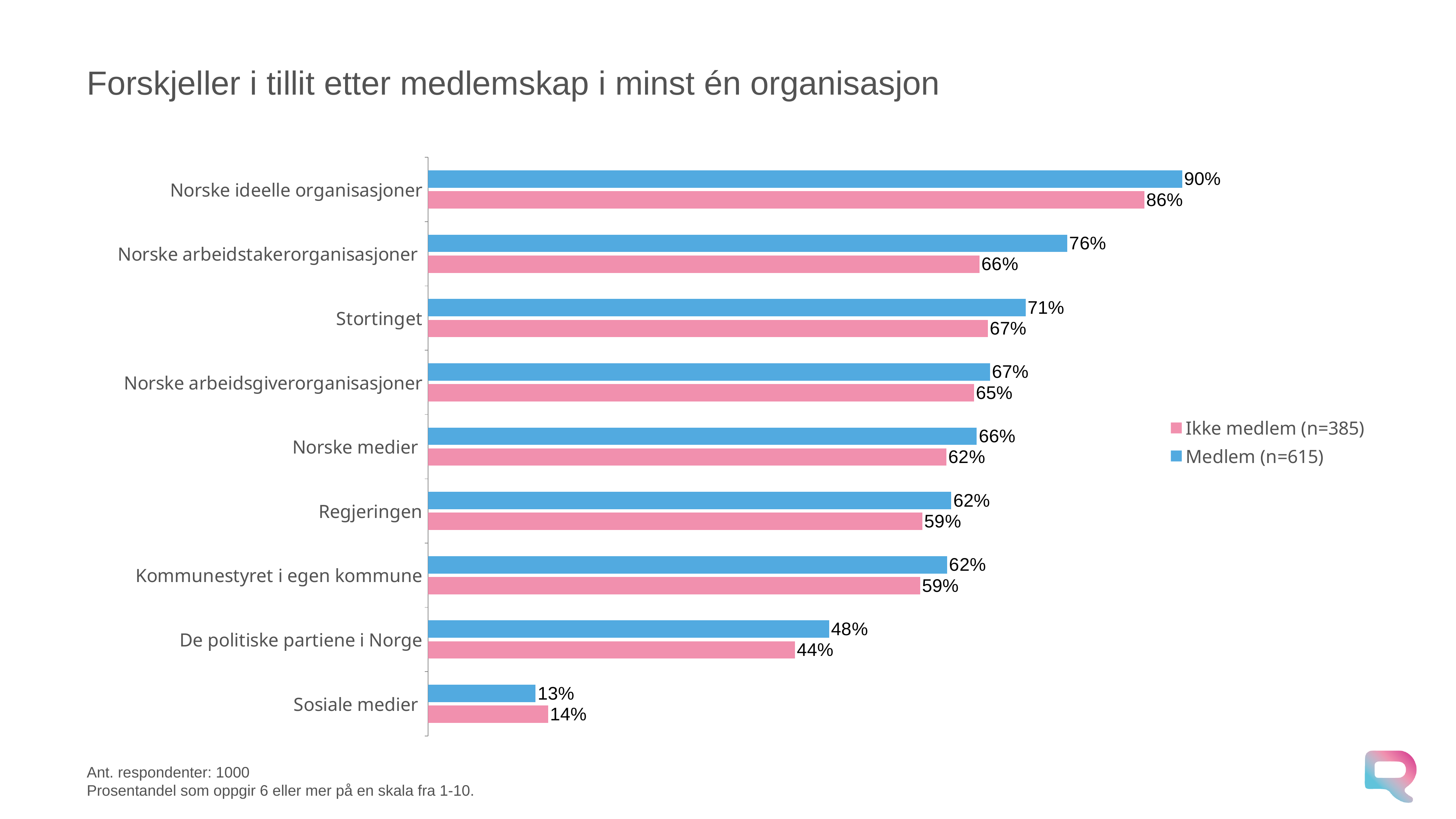
What is the value for Ikke medlem (n=385) for Sosiale medier? 14% What is the value for Ikke medlem (n=385) for Norske arbeidstakerorganisasjoner? 66% For Sosiale medier, which series has the larger value: Medlem (n=615) or Ikke medlem (n=385)? Ikke medlem (n=385) Which is larger: the Medlem (n=615) value for De politiske partiene i Norge or the Ikke medlem (n=385) value for Regjeringen? Ikke medlem (n=385) value for Regjeringen Which category has the lowest value for Ikke medlem (n=385)? Sosiale medier How many series does the legend list? 2 What kind of chart is shown on the slide? Bar chart Which category has the highest value for Medlem (n=615)? Norske ideelle organisasjoner What is the difference between the Medlem (n=615) values for Stortinget and Regjeringen? 9% What is the value for Medlem (n=615) for Norske ideelle organisasjoner? 90% What is the difference between the Medlem (n=615) and Ikke medlem (n=385) values for Norske arbeidstakerorganisasjoner? 10% How many categories are shown on the chart? 9